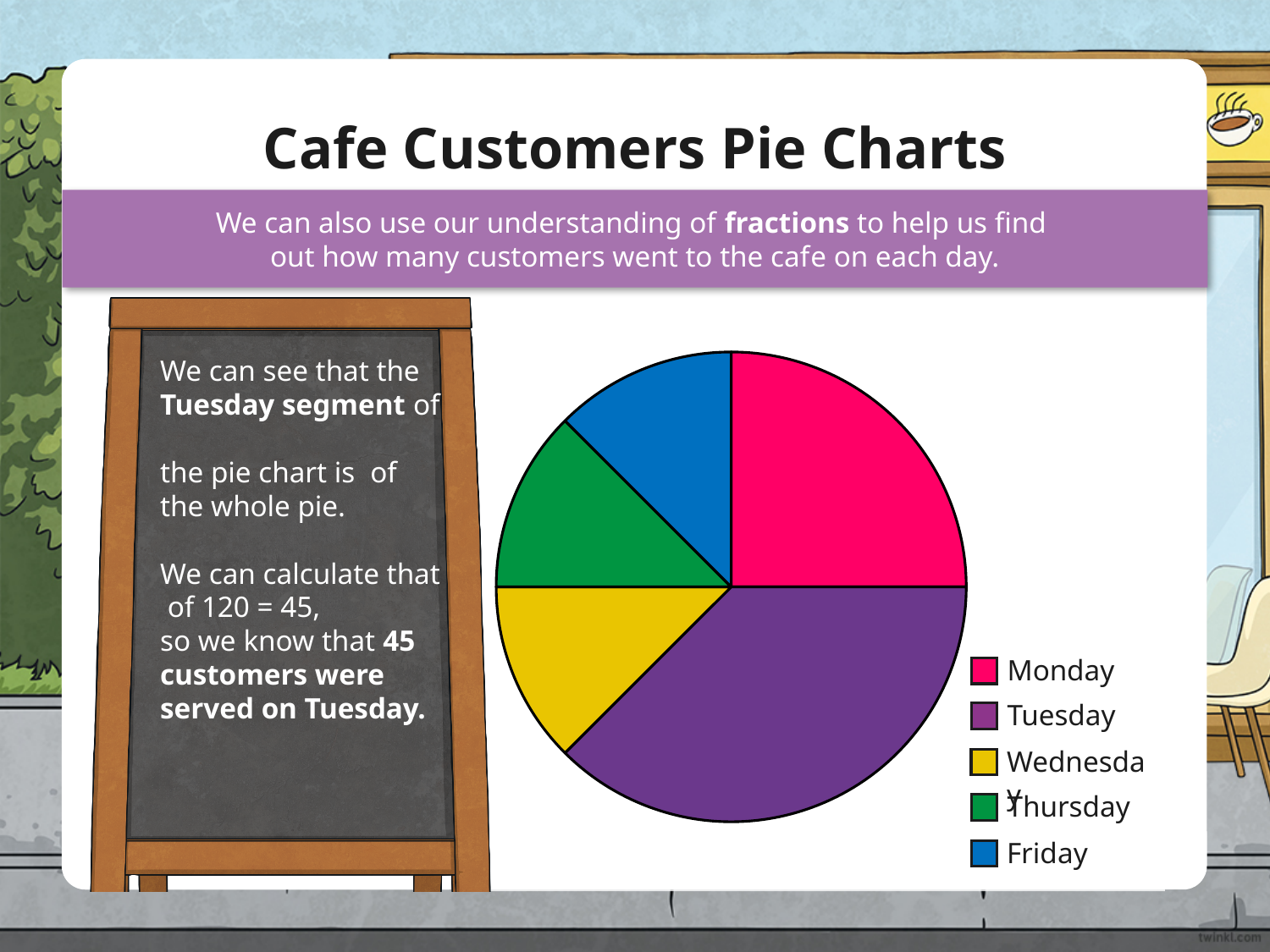
How many categories (days) does the pie chart show? 5 What colour represents Tuesday in the pie chart? purple What kind of chart is shown on the slide? pie chart Which slice is larger, Monday or Tuesday? Tuesday How many entries does the legend list? 5 Which slice is larger, Tuesday or Thursday? Tuesday According to the slide, what is the total number of customers represented by the whole pie? 120 Which slice is larger, Monday or Friday? Monday According to the slide, how many customers were served on Tuesday? 45 What is the title of the slide? Cafe Customers Pie Charts Which day has the largest slice of the pie chart? Tuesday